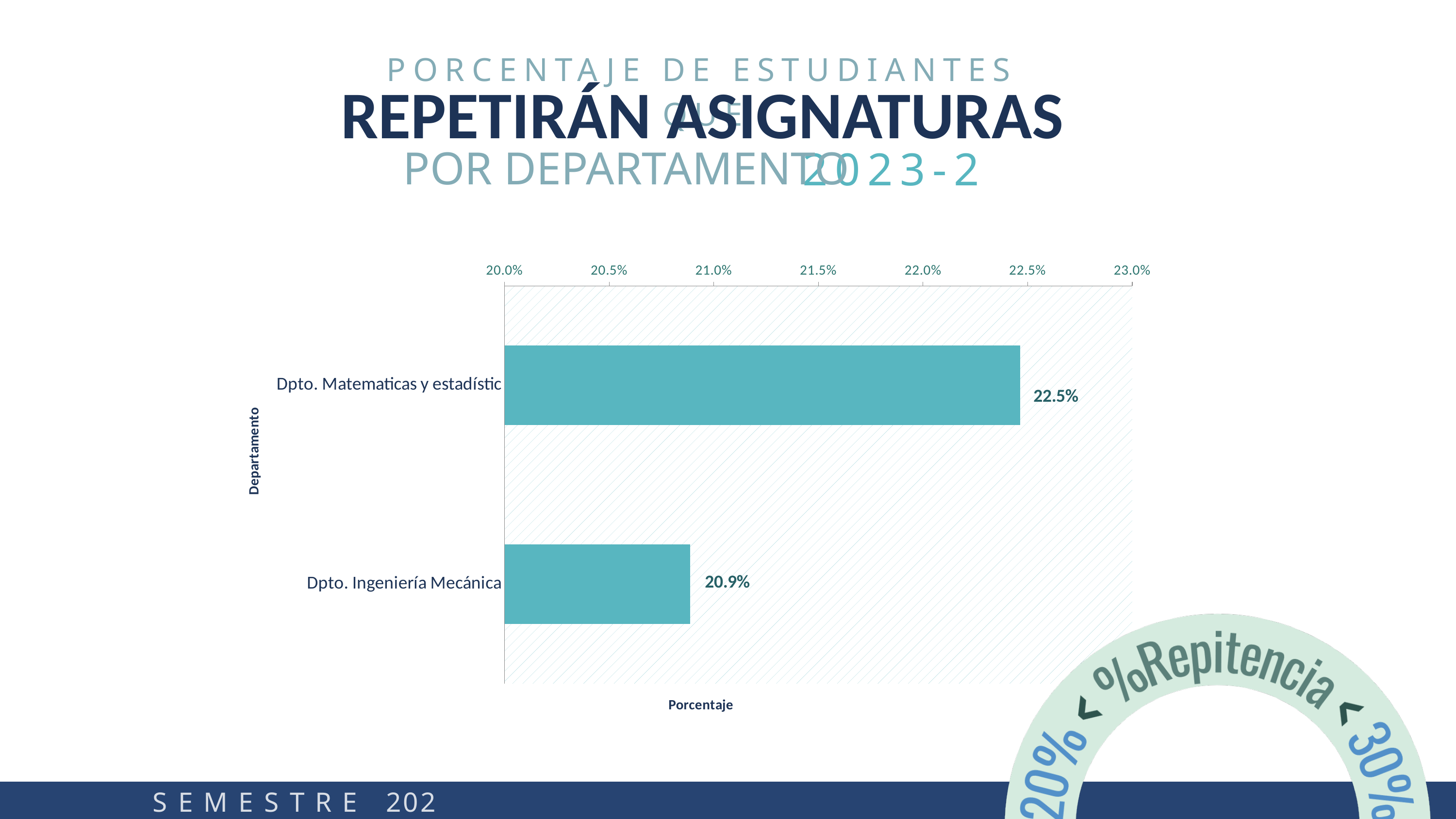
What is the label of the horizontal axis? Porcentaje What is the difference between the values for Dpto. Matematicas y estadístic and Dpto. Ingeniería Mecánica? 1.6% Which is larger, the value for Dpto. Ingeniería Mecánica or the value for Dpto. Matematicas y estadístic? Dpto. Matematicas y estadístic How many departments are shown in the chart? 2 What is the label of the vertical axis? Departamento What is the value for Dpto. Matematicas y estadístic? 22.5% Which department has the highest percentage? Dpto. Matematicas y estadístic Which department has the lowest percentage? Dpto. Ingeniería Mecánica Is the value for Dpto. Matematicas y estadístic greater or less than 22.0%? greater What is the value for Dpto. Ingeniería Mecánica? 20.9% Is the value for Dpto. Ingeniería Mecánica greater or less than 21.0%? less What kind of chart is shown on the slide? bar chart